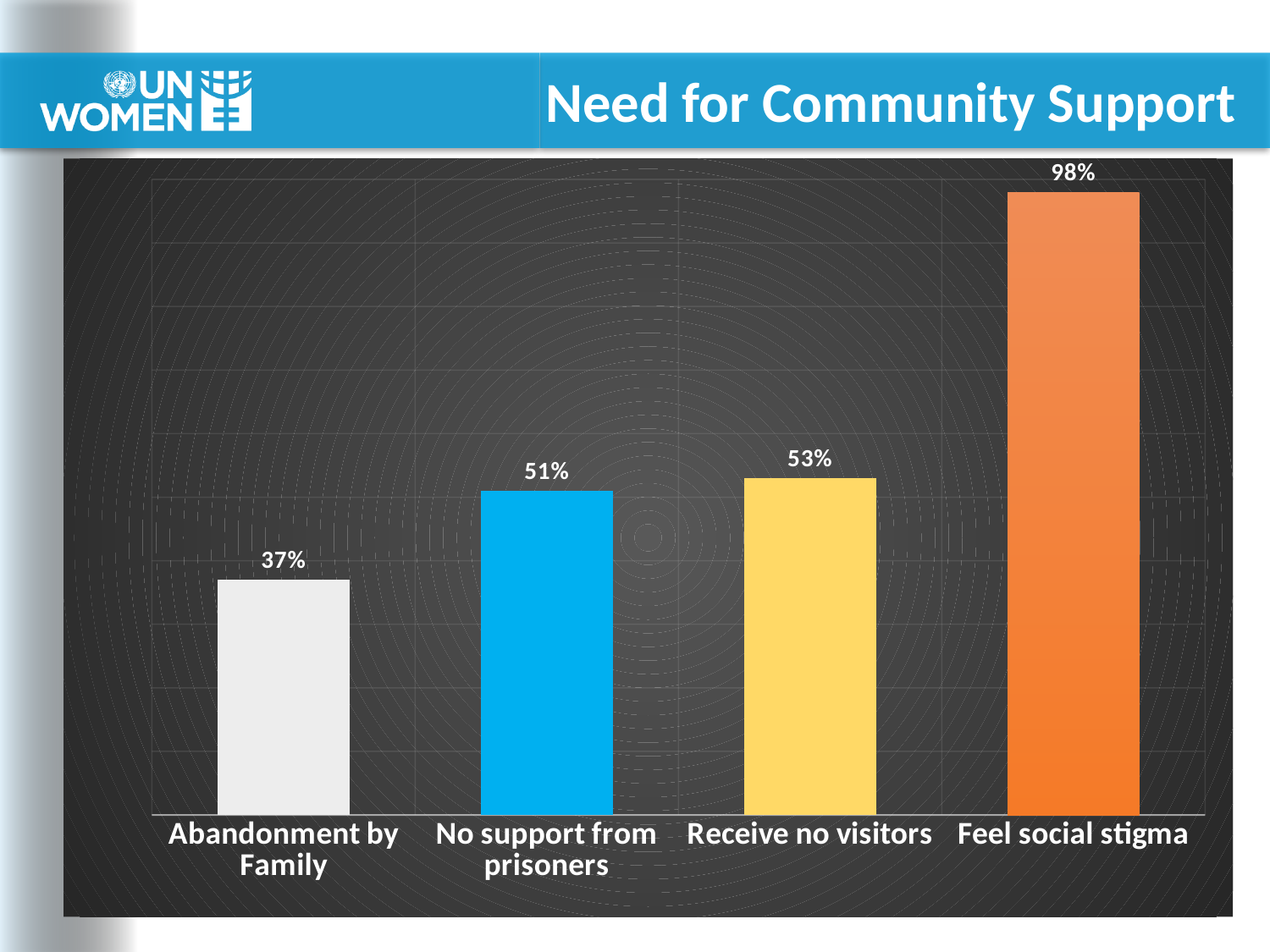
What is the difference between the values for Receive no visitors and No support from prisoners? 2% Which category has the lowest value? Abandonment by Family What is the value for Abandonment by Family? 37% Which is larger, the value for Feel social stigma or the value for Receive no visitors? Feel social stigma Which category has the highest value? Feel social stigma What is the title of the slide containing the chart? Need for Community Support What is the value for No support from prisoners? 51% What is the value for Receive no visitors? 53% How many categories are shown in the chart? 4 What is the value for Feel social stigma? 98% What kind of chart is shown on the slide? Bar chart What is the difference between the values for Feel social stigma and Abandonment by Family? 61%